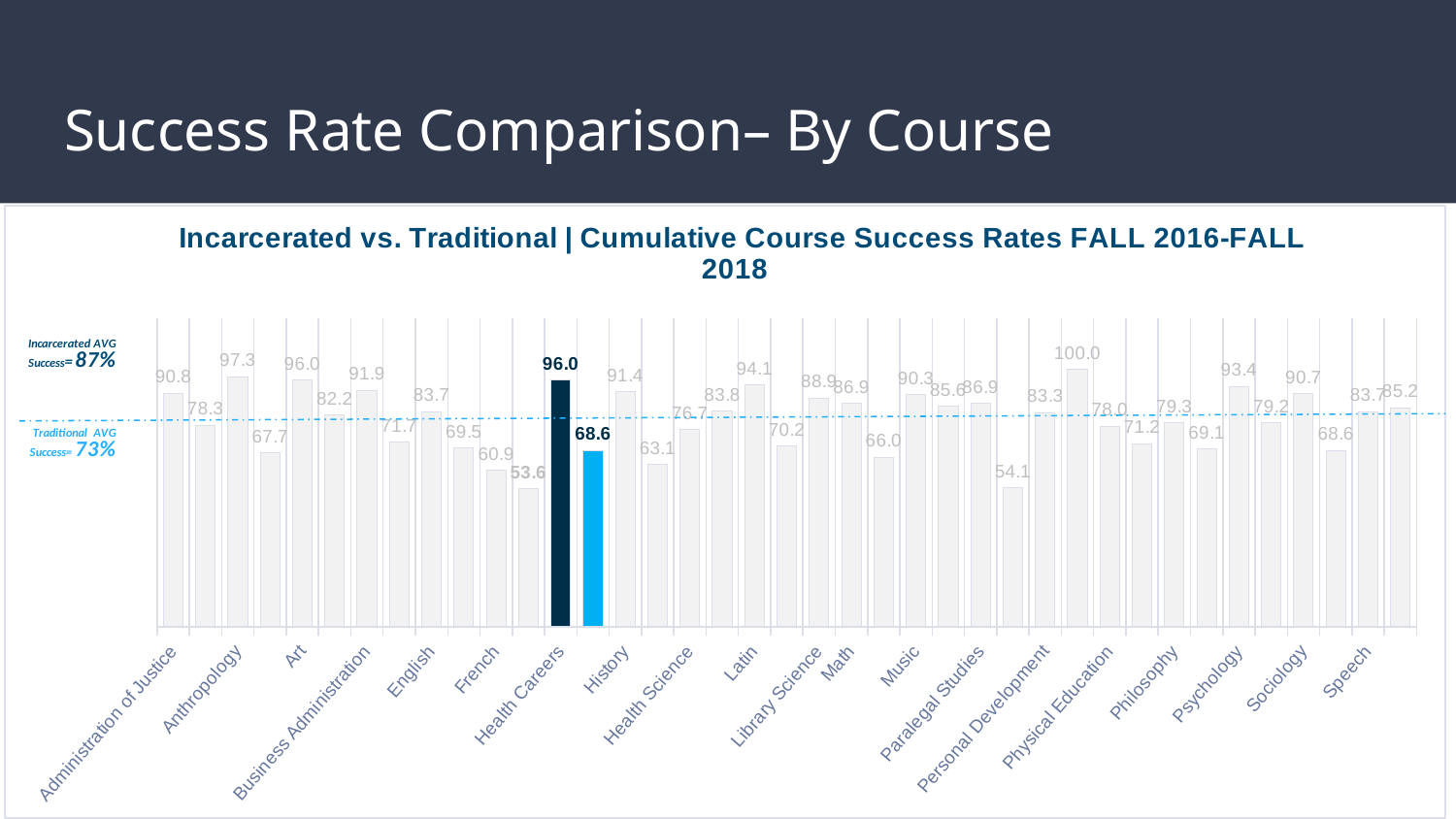
What is the difference between the two highlighted Health Careers bars (96.0 and 68.6)? 27.4 Which of the two highlighted Health Careers bars is larger, the dark navy one or the light blue one? The dark navy one How many courses are listed along the x axis? 20 Which course has the bar labeled 100.0? Personal Development What is the Traditional AVG Success rate noted on the left of the chart? 73% What is the lowest data label shown on the chart? 53.6 What is the Incarcerated AVG Success rate noted on the left of the chart? 87% What is the highest data label shown on the chart? 100.0 Which course has the bar labeled 53.6? French What is the value of the light blue highlighted bar for Health Careers? 68.6 What is the value of the dark navy highlighted bar for Health Careers? 96.0 What type of chart is shown on the slide? Bar chart